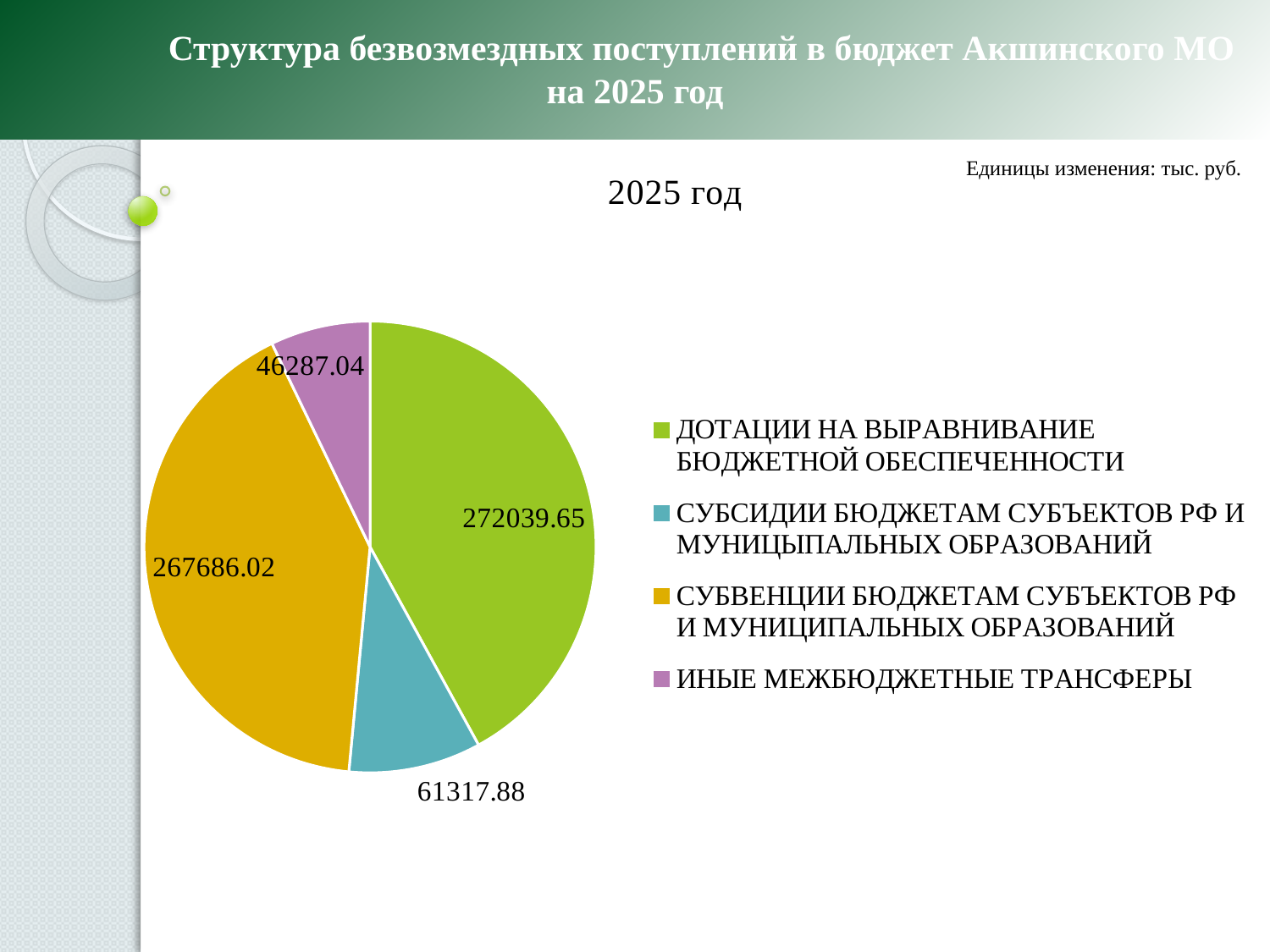
What is the value for ИНЫЕ МЕЖБЮДЖЕТНЫЕ ТРАНСФЕРЫ? 46287.04 What is the value for СУБВЕНЦИИ БЮДЖЕТАМ СУБЪЕКТОВ РФ И МУНИЦИПАЛЬНЫХ ОБРАЗОВАНИЙ? 267686.02 What is the value for ДОТАЦИИ НА ВЫРАВНИВАНИЕ БЮДЖЕТНОЙ ОБЕСПЕЧЕННОСТИ? 272039.65 What is the title shown above the pie chart? 2025 год Which category has the largest value in the pie chart? ДОТАЦИИ НА ВЫРАВНИВАНИЕ БЮДЖЕТНОЙ ОБЕСПЕЧЕННОСТИ How many slices does the pie chart have? 4 Which is larger: the value for СУБСИДИИ БЮДЖЕТАМ СУБЪЕКТОВ РФ И МУНИЦЫПАЛЬНЫХ ОБРАЗОВАНИЙ or the value for ИНЫЕ МЕЖБЮДЖЕТНЫЕ ТРАНСФЕРЫ? СУБСИДИИ БЮДЖЕТАМ СУБЪЕКТОВ РФ И МУНИЦЫПАЛЬНЫХ ОБРАЗОВАНИЙ What is the difference between the values for ДОТАЦИИ НА ВЫРАВНИВАНИЕ БЮДЖЕТНОЙ ОБЕСПЕЧЕННОСТИ and СУБВЕНЦИИ БЮДЖЕТАМ СУБЪЕКТОВ РФ И МУНИЦИПАЛЬНЫХ ОБРАЗОВАНИЙ? 4353.63 What type of chart is shown on the slide? pie chart What is the value for СУБСИДИИ БЮДЖЕТАМ СУБЪЕКТОВ РФ И МУНИЦЫПАЛЬНЫХ ОБРАЗОВАНИЙ? 61317.88 What is the difference between the values for СУБСИДИИ БЮДЖЕТАМ СУБЪЕКТОВ РФ И МУНИЦЫПАЛЬНЫХ ОБРАЗОВАНИЙ and ИНЫЕ МЕЖБЮДЖЕТНЫЕ ТРАНСФЕРЫ? 15030.84 Which category has the smallest slice of the pie? ИНЫЕ МЕЖБЮДЖЕТНЫЕ ТРАНСФЕРЫ